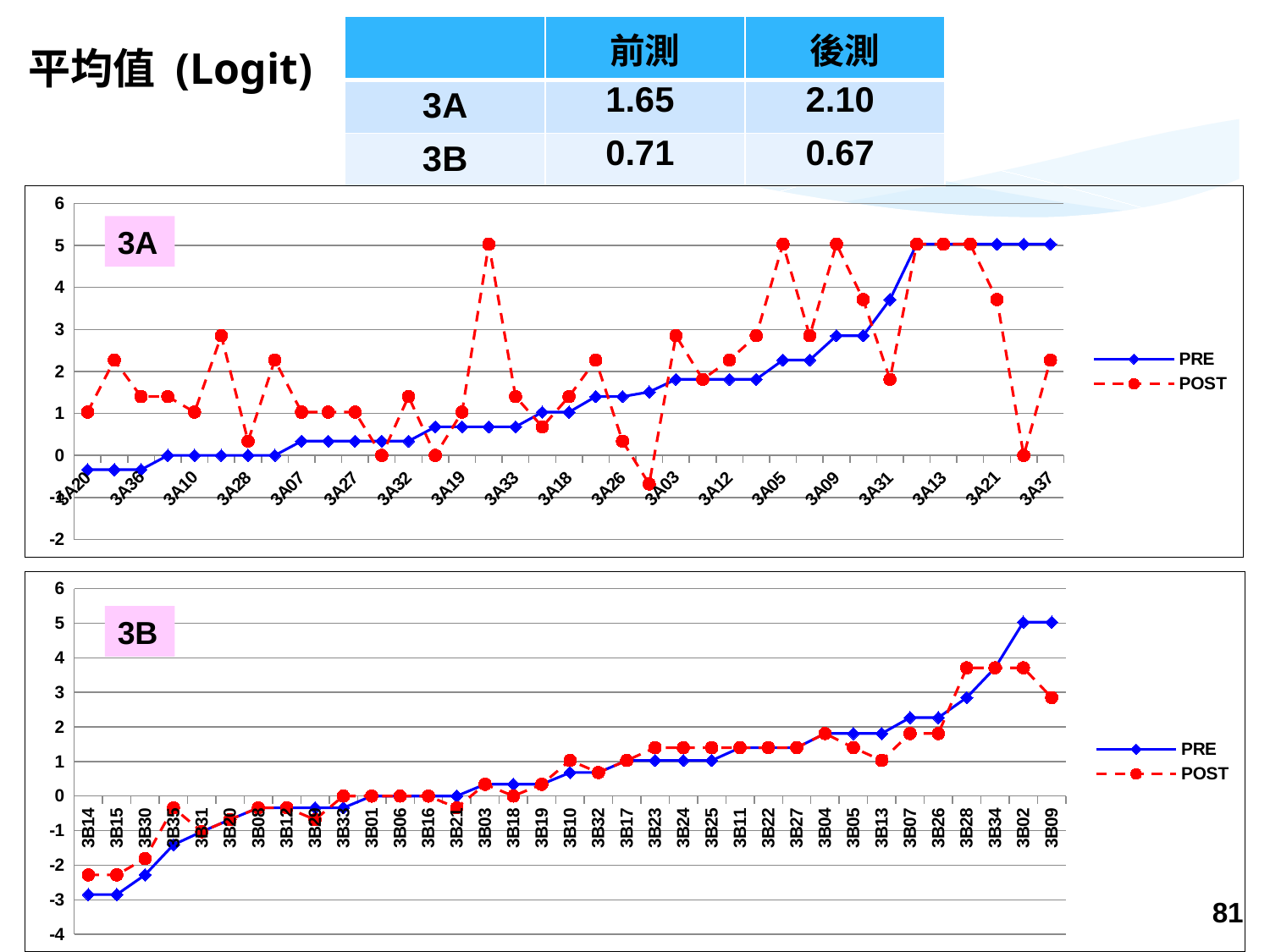
In the 3B chart, which series is drawn with a red dashed line? POST What kind of chart is the 3A chart? line chart How many categories are shown on the x axis of the 3B chart? 35 In the 3A chart, do the PRE values rise or fall from left to right along the x axis? rise What are the two series named in the legend of the 3A chart? PRE and POST In the 3B chart, which series has the larger value at 3B09, PRE or POST? PRE In the 3A chart, which series has the larger value at 3A37, PRE or POST? PRE In the 3A chart, is the PRE value for 3A37 greater or less than 4? greater In the 3B chart, do the PRE values rise or fall from left to right along the x axis? rise How many series does the legend of the 3B chart list? 2 In the 3B chart, is the PRE value for 3B14 greater or less than -2? less In the 3B chart, is the PRE value for 3B02 greater or less than 4? greater